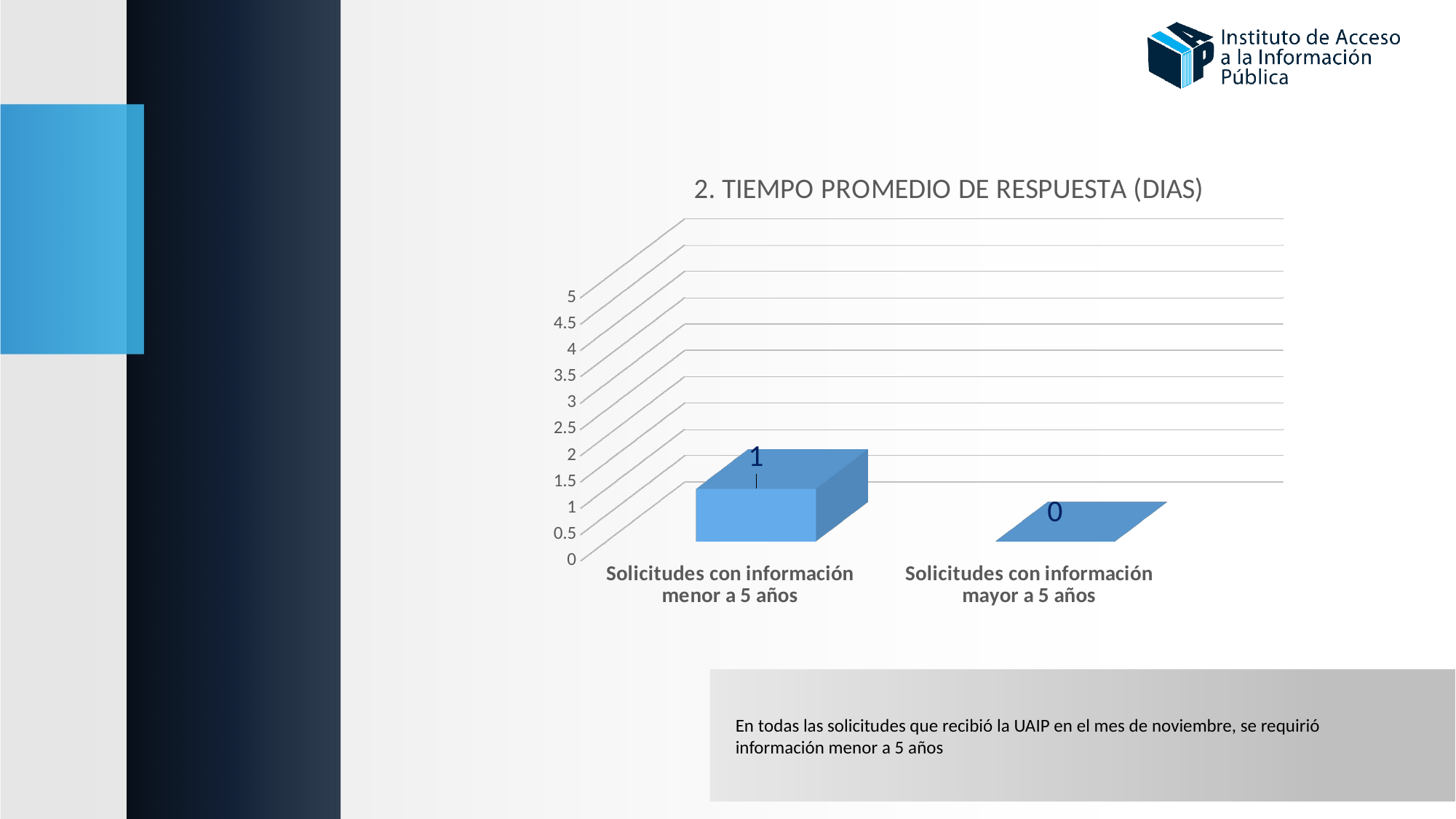
Is the value for "Solicitudes con información menor a 5 años" greater or less than 3? less What is the difference between the values for "Solicitudes con información menor a 5 años" and "Solicitudes con información mayor a 5 años"? 1 What kind of chart is shown on the slide? bar chart Which category has the highest value? Solicitudes con información menor a 5 años What is the value for "Solicitudes con información menor a 5 años"? 1 Which is larger: the value for "Solicitudes con información menor a 5 años" or for "Solicitudes con información mayor a 5 años"? Solicitudes con información menor a 5 años What is the title of the chart? 2. TIEMPO PROMEDIO DE RESPUESTA (DIAS) Do the values rise or fall from left to right along the x axis? fall How many categories are shown on the x axis? 2 What is the value for "Solicitudes con información mayor a 5 años"? 0 What is the highest value shown on the vertical axis? 5 Which category has the lowest value? Solicitudes con información mayor a 5 años